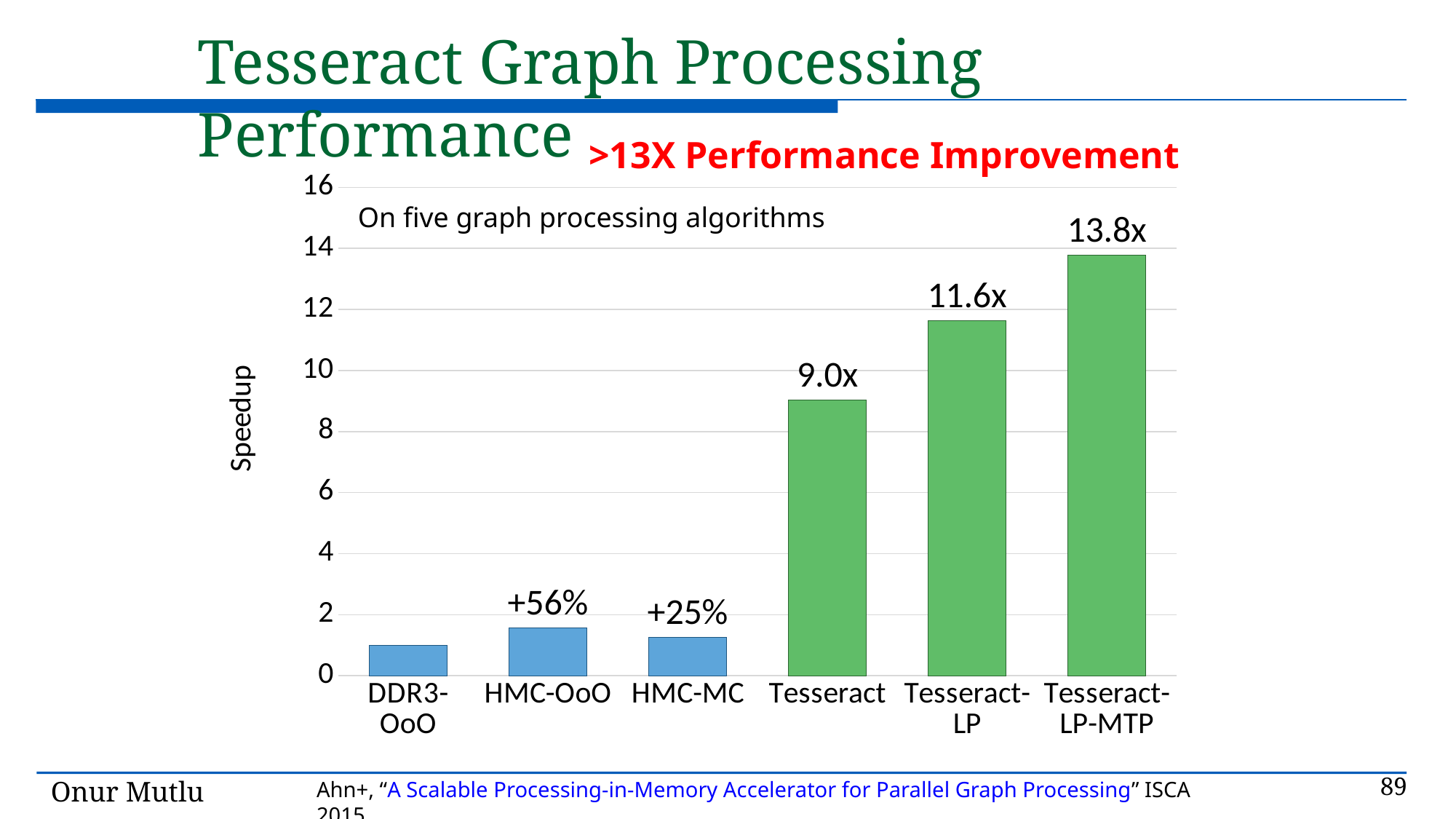
What is the speedup value labelled for Tesseract-LP-MTP? 13.8x What label is printed above the HMC-OoO bar? +56% Which has a larger speedup, HMC-OoO or HMC-MC? HMC-OoO Which category has the highest speedup? Tesseract-LP-MTP Is the speedup for DDR3-OoO greater or less than 2? less What is the speedup value labelled for Tesseract-LP? 11.6x What is the title of the y axis? Speedup How many categories are shown on the x axis of the chart? 6 What is the speedup value labelled for Tesseract? 9.0x What is the difference in speedup between Tesseract-LP-MTP and Tesseract? 4.8x Which category has the lowest speedup? DDR3-OoO What kind of chart is shown on the slide? bar chart